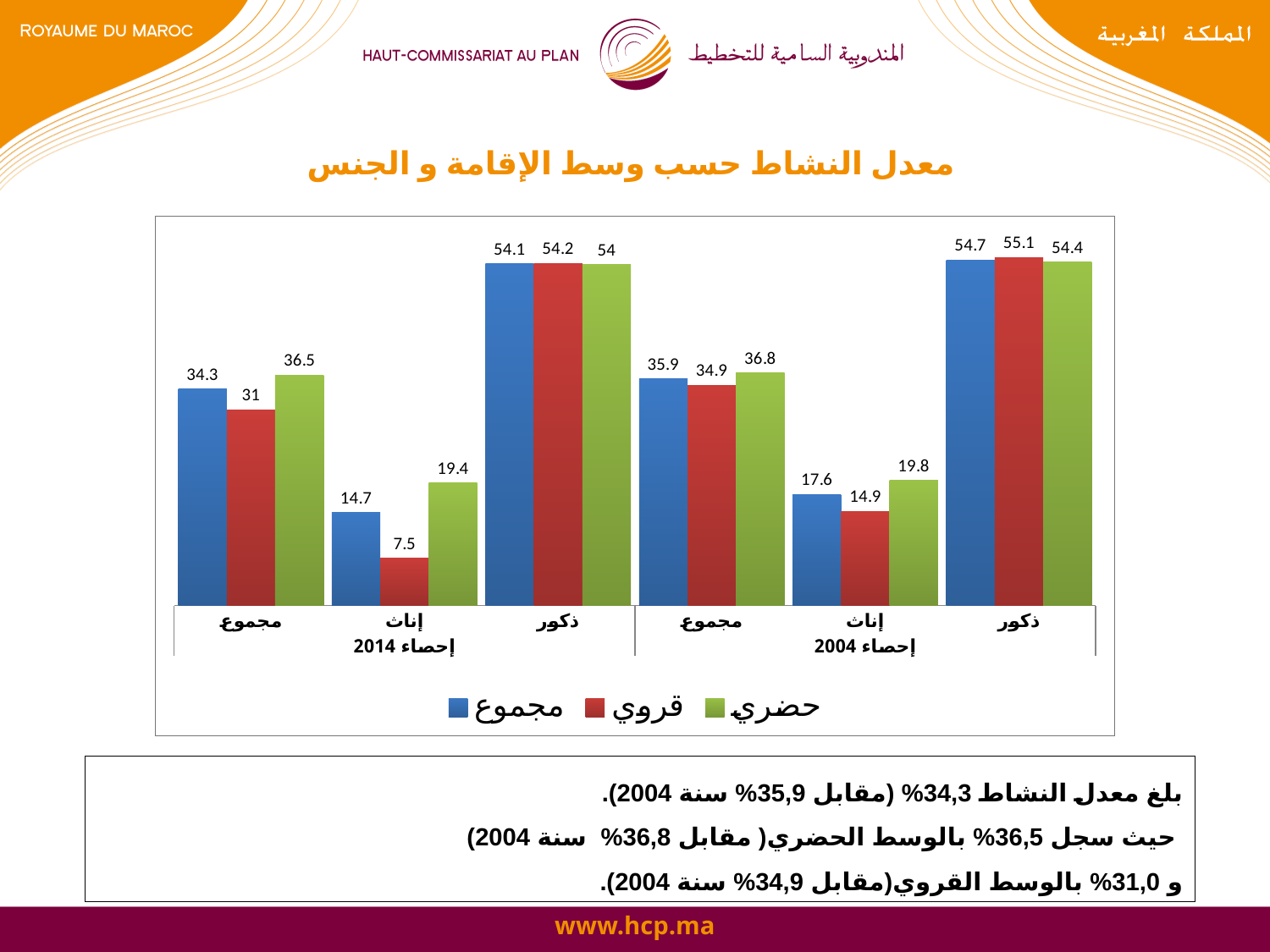
What is the difference between the حضري and قروي values for إناث in إحصاء 2014? 11.9 What is the value of the قروي (rural) series for ذكور in إحصاء 2004? 55.1 Which is larger: the مجموع value for إناث in إحصاء 2014 or in إحصاء 2004? إحصاء 2004 Which series has the highest value for إناث in إحصاء 2014? حضري What is the value of the حضري (urban) series for مجموع in إحصاء 2004? 36.8 What is the value of the مجموع (total) series for ذكور in إحصاء 2014? 54.1 What type of chart is shown on the slide? bar chart What is the value of the قروي (rural) series for إناث in إحصاء 2014? 7.5 Which series has the lowest value for مجموع in إحصاء 2014? قروي How many series does the legend list? 3 What colour represents the قروي (rural) series in the chart? red How many category groups are shown on the x axis of the chart? 6